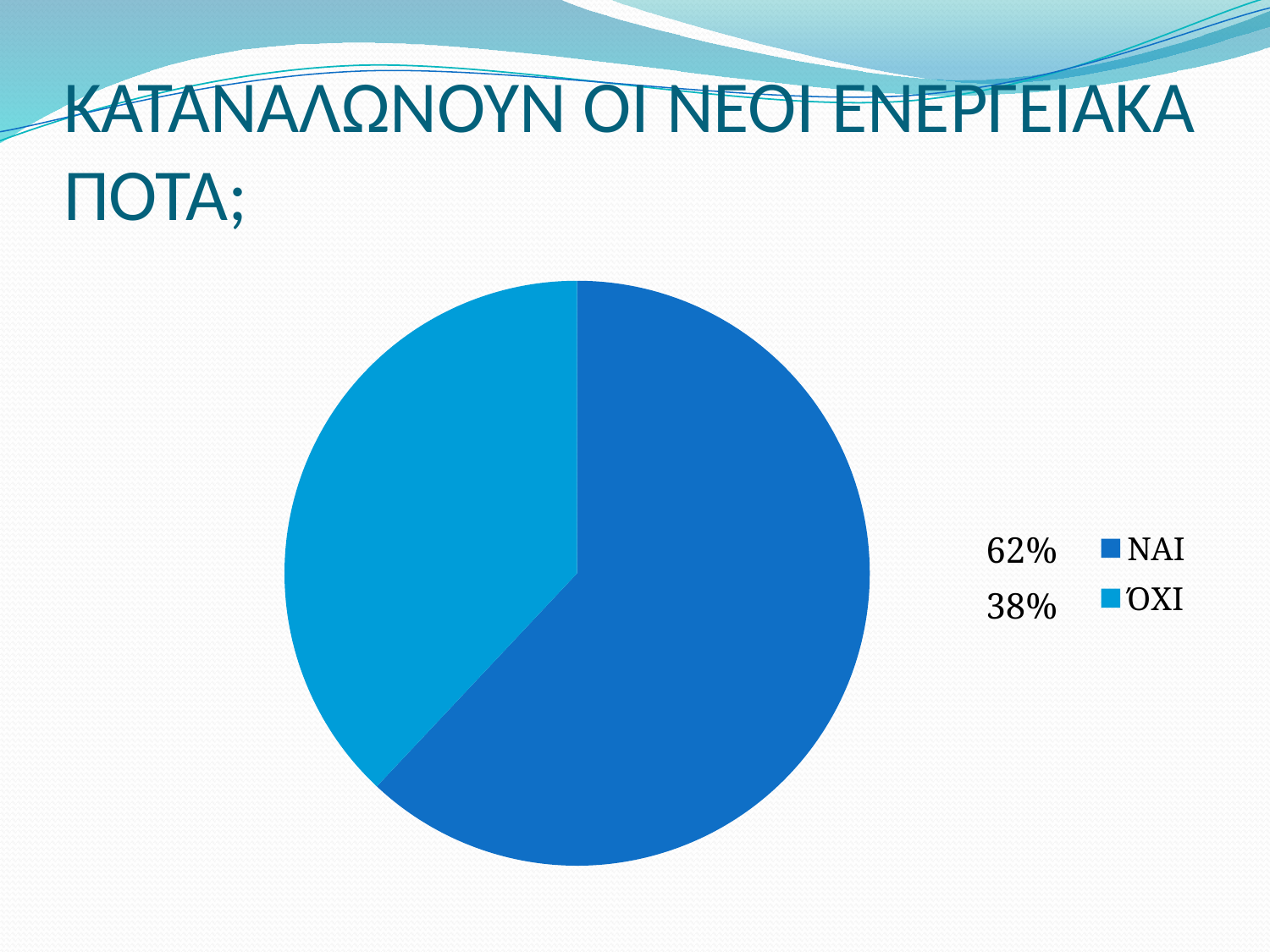
Which category has the smallest slice of the pie? ΌΧΙ Which legend entry is shown in the lighter blue colour? ΌΧΙ What share of the pie does ΌΧΙ represent? 38% What is the difference in percentage points between the ΝΑΙ and ΌΧΙ slices? 24 What is the title of the slide containing the pie chart? ΚΑΤΑΝΑΛΩΝΟΥΝ ΟΙ ΝΕΟΙ ΕΝΕΡΓΕΙΑΚΑ ΠΟΤΑ; How many slices does the pie chart have? 2 Which category has the largest slice of the pie? ΝΑΙ Which is larger, the slice for ΝΑΙ or the slice for ΌΧΙ? ΝΑΙ What share of the pie does ΝΑΙ represent? 62% What kind of chart is shown on the slide? pie chart How many entries does the legend list? 2